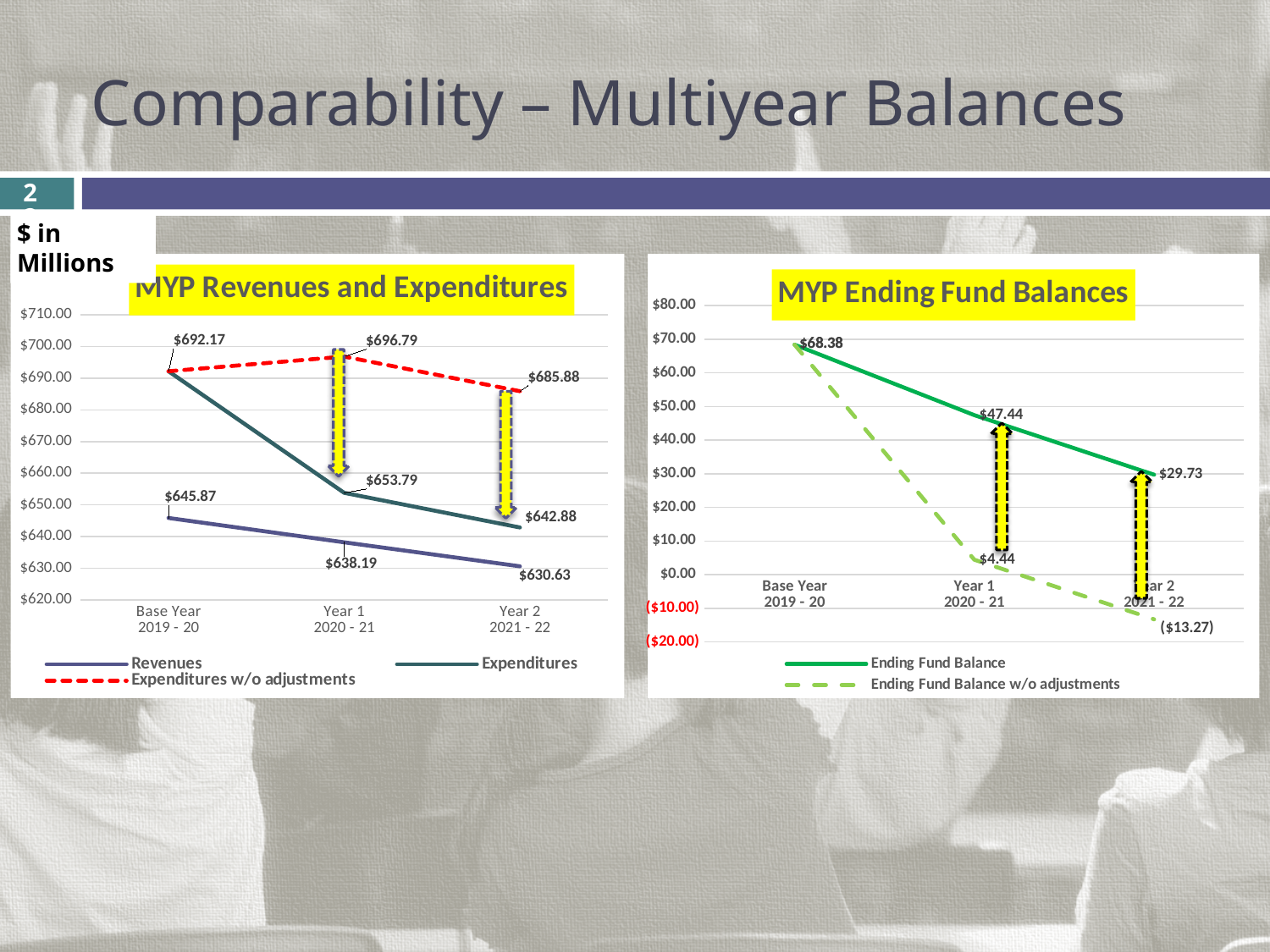
What kind of chart is the MYP Ending Fund Balances chart? Line chart How many series does the legend of the MYP Ending Fund Balances chart list? 2 In the MYP Revenues and Expenditures chart, what is the Revenues value for Year 2 2021 - 22? $630.63 In the MYP Revenues and Expenditures chart, do Revenues rise or fall from the Base Year to Year 2? Fall In the MYP Ending Fund Balances chart, in which year is the Ending Fund Balance lowest? Year 2 2021 - 22 In the MYP Revenues and Expenditures chart, what is the Expenditures value for Year 1 2020 - 21? $653.79 In the MYP Ending Fund Balances chart, how much higher is the Ending Fund Balance than the Ending Fund Balance w/o adjustments in Year 1 2020 - 21? $43.00 In the MYP Ending Fund Balances chart, what is the Ending Fund Balance for Year 1 2020 - 21? $47.44 In the MYP Revenues and Expenditures chart, what is the difference between Expenditures w/o adjustments and Expenditures in Year 2 2021 - 22? $43.00 In the MYP Ending Fund Balances chart, what is the Ending Fund Balance w/o adjustments for Year 2 2021 - 22? ($13.27) How many series does the legend of the MYP Revenues and Expenditures chart list? 3 In the MYP Revenues and Expenditures chart, which is larger in Year 1 2020 - 21, Revenues or Expenditures? Expenditures